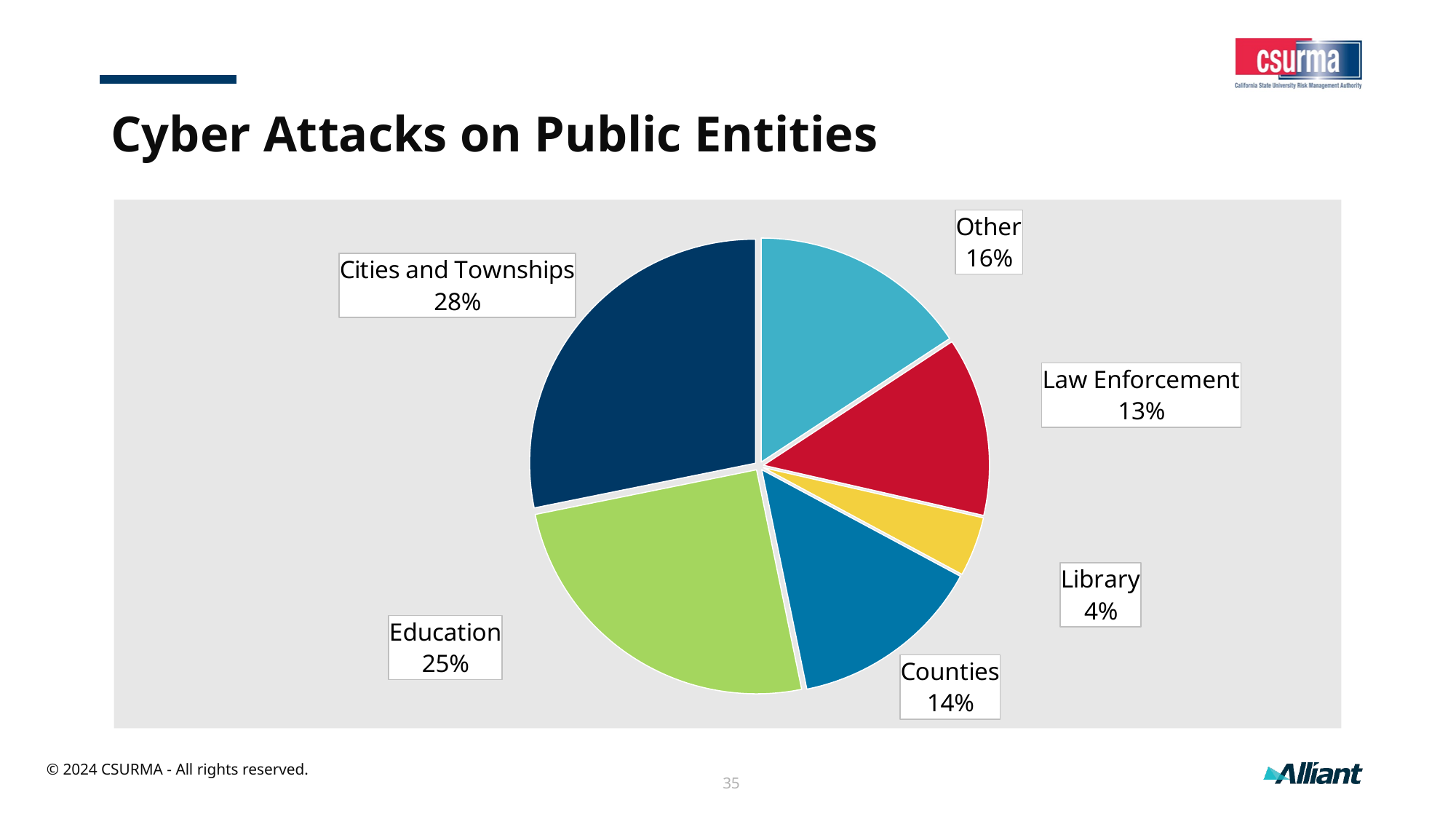
How many categories are shown in the pie chart? 6 What is the difference between the Other slice and the Counties slice? 2% What percentage of the pie chart is Education? 25% What share of cyber attacks on public entities is attributed to Cities and Townships? 28% What is the title of the slide containing the chart? Cyber Attacks on Public Entities Which is larger, the Counties slice or the Law Enforcement slice? Counties What is the difference in percentage points between Cities and Townships and Education? 3% What type of chart is shown on the slide? Pie chart Which category has the smallest slice of the pie? Library Which category has the largest slice of the pie? Cities and Townships What is the value shown for Law Enforcement? 13% What percentage does the Library slice represent? 4%